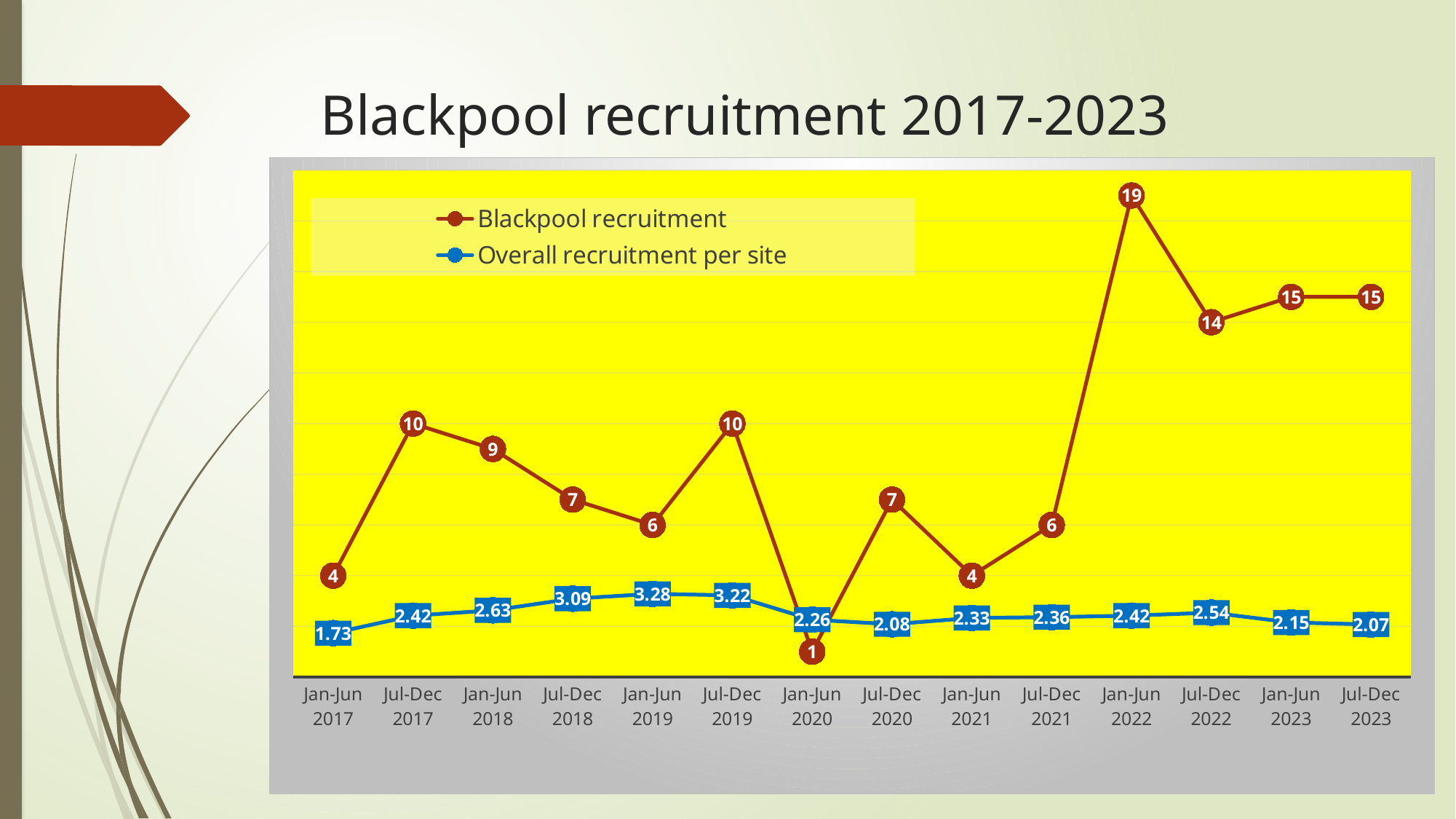
What is the Blackpool recruitment value for Jan-Jun 2020? 1 What is the Overall recruitment per site value for Jul-Dec 2023? 2.07 In which period is Overall recruitment per site highest? Jan-Jun 2019 What kind of chart is shown on the slide? Line chart In which period is Blackpool recruitment highest? Jan-Jun 2022 What is the difference between Blackpool recruitment in Jan-Jun 2022 and Jul-Dec 2022? 5 In which period is Blackpool recruitment lowest? Jan-Jun 2020 How many periods are shown on the x axis? 14 What is the Overall recruitment per site value for Jan-Jun 2017? 1.73 Which is larger: Blackpool recruitment in Jul-Dec 2017 or in Jan-Jun 2018? Jul-Dec 2017 How many series does the legend list? 2 What is the Blackpool recruitment value for Jan-Jun 2022? 19